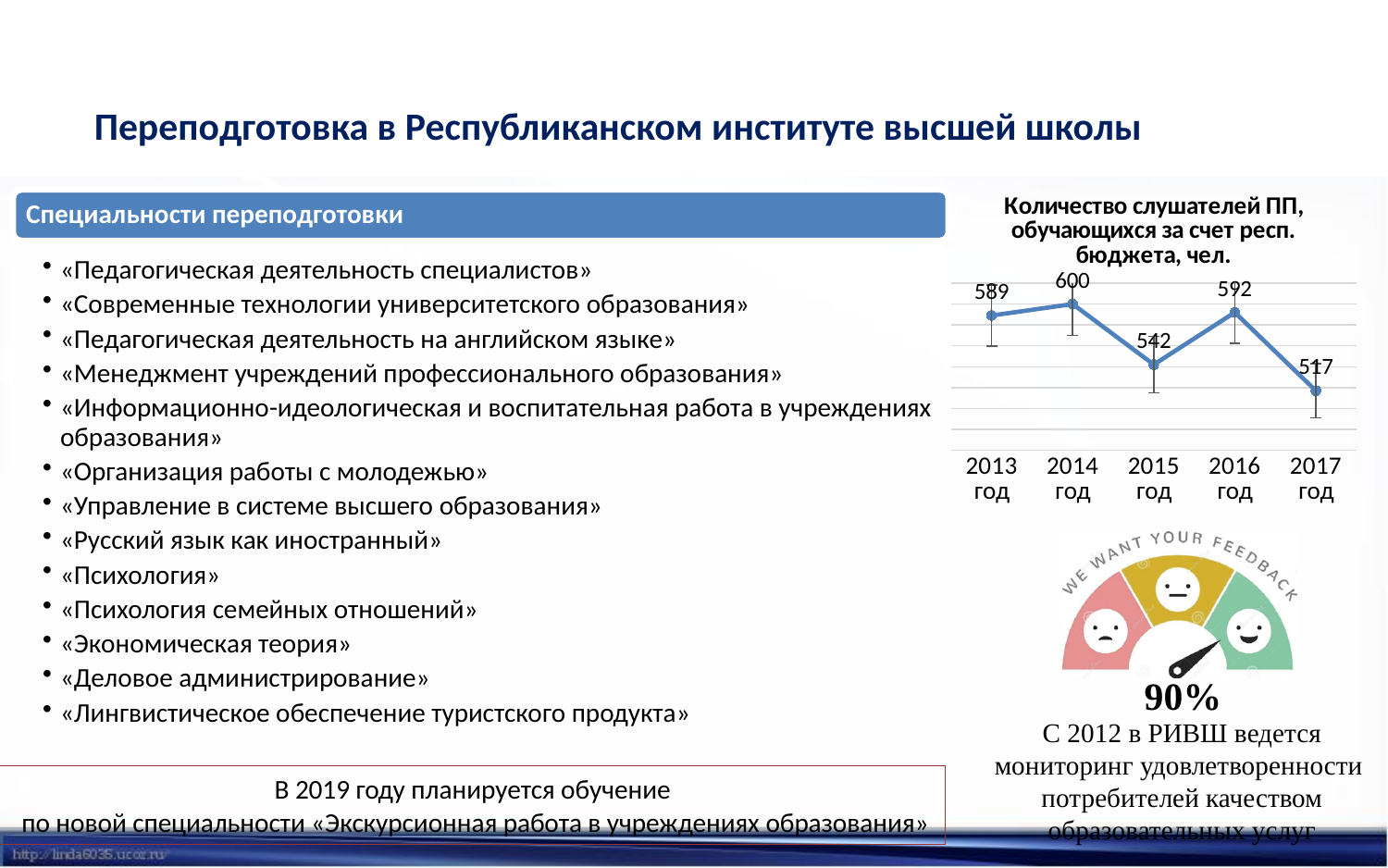
What is the title of the chart on the slide? Количество слушателей ПП, обучающихся за счет респ. бюджета, чел. Which is larger, the value for 2013 год or the value for 2015 год? 2013 год Which year has the lowest value in the chart? 2017 год How many years are plotted in the chart? 5 What kind of chart is shown on the slide? line chart What is the value for 2017 год in the chart? 517 Which year has the highest value in the chart? 2014 год Does the value rise or fall from 2016 год to 2017 год? fall What is the difference between the values for 2016 год and 2015 год? 50 What is the value for 2015 год in the chart? 542 What is the value for 2014 год in the chart "Количество слушателей ПП, обучающихся за счет респ. бюджета, чел."? 600 What is the difference between the values for 2014 год and 2017 год? 83